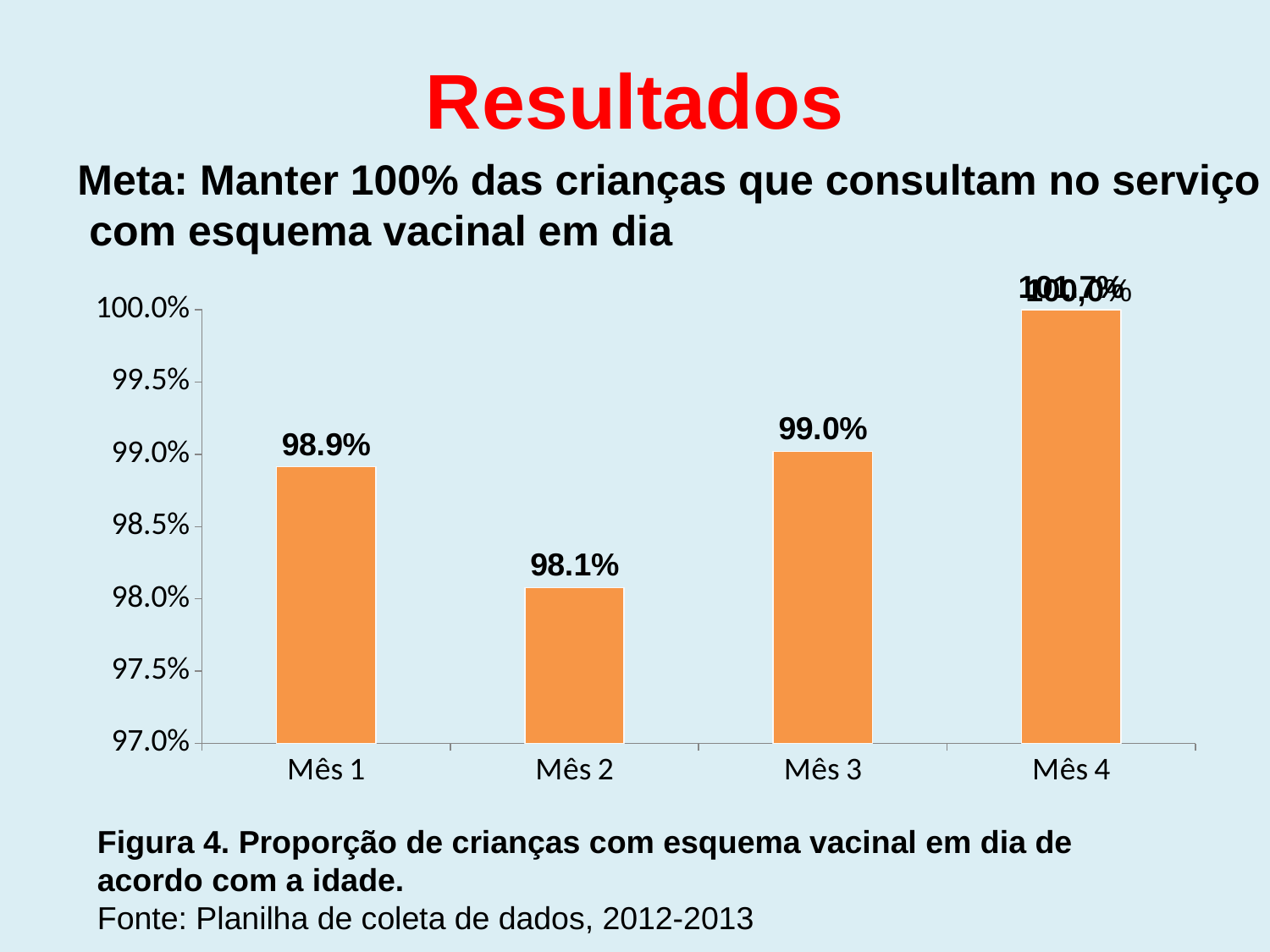
Which is larger, the value for Mês 1 or the value for Mês 2? Mês 1 Which month has the lowest value? Mês 2 What is the value for Mês 3? 99.0% What colour are the bars in the chart? orange How many months are shown on the x axis? 4 Which month has the highest value? Mês 4 What is the difference between the values for Mês 1 and Mês 2? 0.8% What kind of chart is shown on the slide? bar chart Is the value for Mês 2 greater or less than 98.5%? less What is the value for Mês 2? 98.1% Is the value for Mês 4 greater or less than 99.5%? greater What is the value for Mês 1? 98.9%